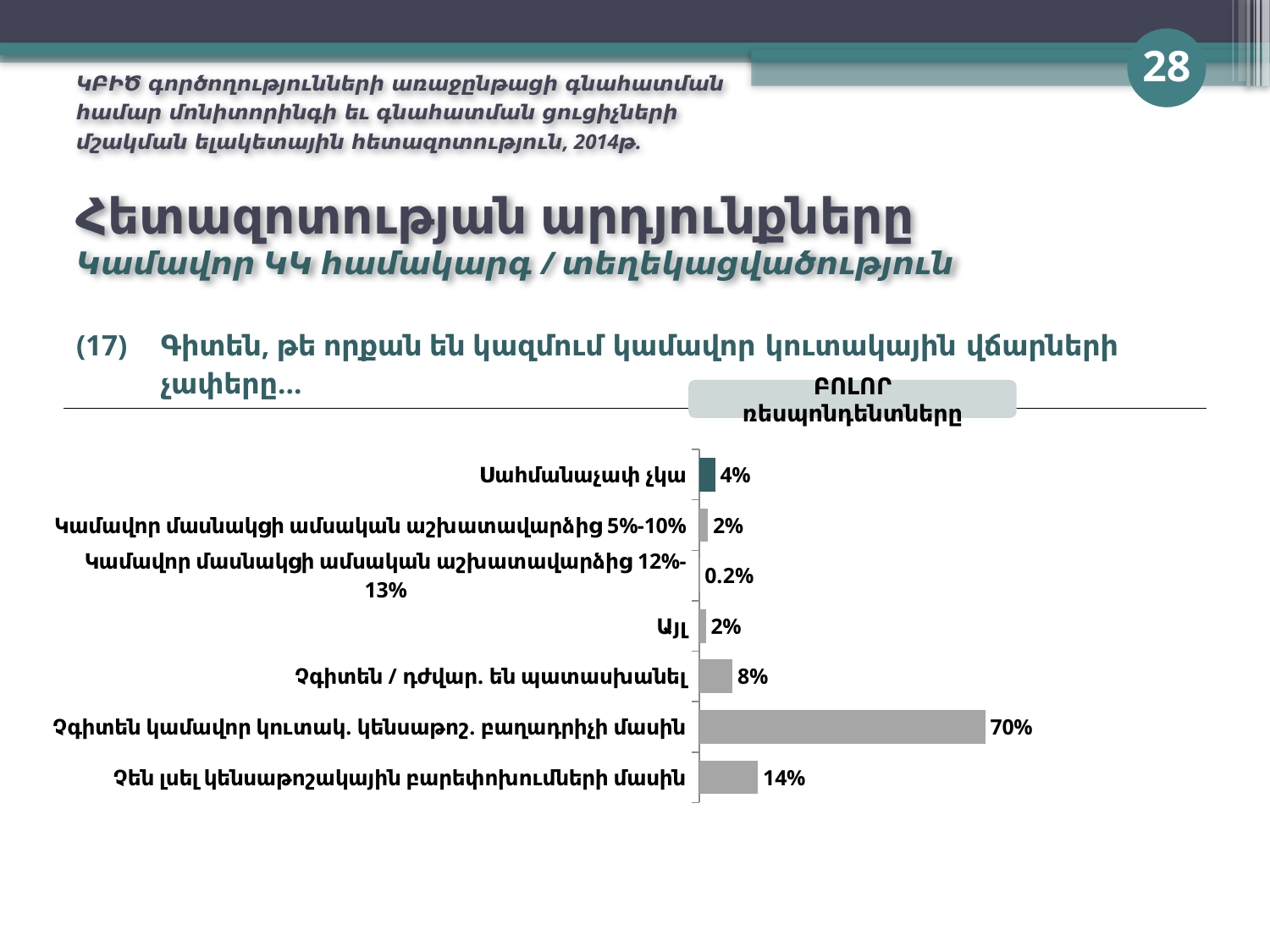
What is the value for "Չգիտեն կամավոր կուտակ. կենսաթոշ. բաղադրիչի մասին"? 70% What is the difference between the values for "Չգիտեն կամավոր կուտակ. կենսաթոշ. բաղադրիչի մասին" and "Չեն լսել կենսաթոշակային բարեփոխումների մասին"? 56% What is the value for "Չեն լսել կենսաթոշակային բարեփոխումների մասին"? 14% What is the value for "Կամավոր մասնակցի ամսական աշխատավարձից 12%-13%"? 0.2% What is the value for "Չգիտեն / դժվար. են պատասխանել"? 8% Which category has the highest value? Չգիտեն կամավոր կուտակ. կենսաթոշ. բաղադրիչի մասին Which category has the lowest value? Կամավոր մասնակցի ամսական աշխատավարձից 12%-13% What kind of chart is shown on the slide? Bar chart What is the label shown in the box above the chart? ԲՈԼՈՐ ռեսպոնդենտները How many categories are shown in the chart? 7 What is the value for "Սահմանաչափ չկա"? 4% Which is larger: the value for "Սահմանաչափ չկա" or the value for "Չգիտեն / դժվար. են պատասխանել"? Չգիտեն / դժվար. են պատասխանել